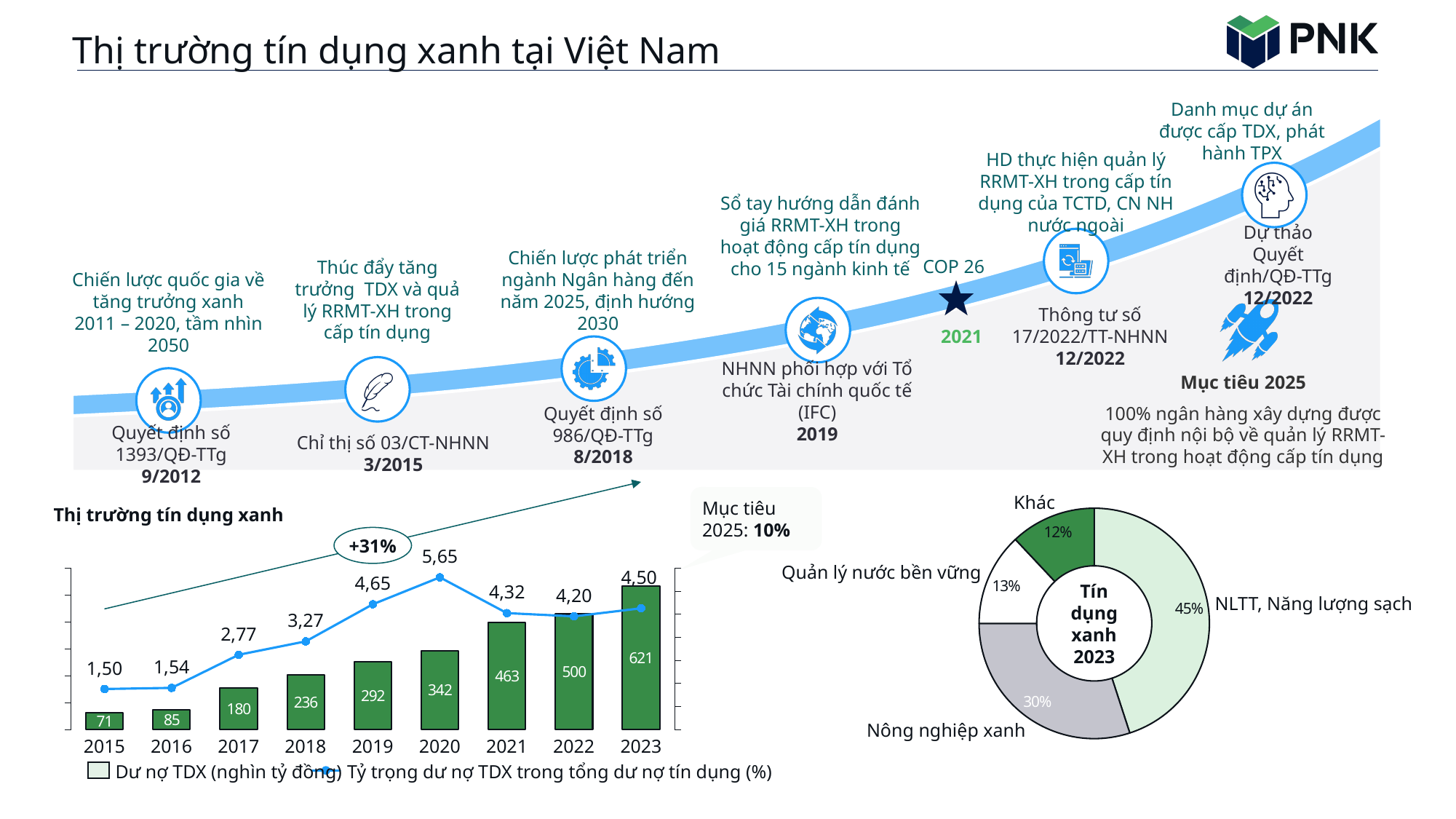
In the chart titled "Thị trường tín dụng xanh", which year has a larger Dư nợ TDX (nghìn tỷ đồng): 2019 or 2021? 2021 In the chart titled "Thị trường tín dụng xanh", which year has the highest Tỷ trọng dư nợ TDX trong tổng dư nợ tín dụng (%)? 2020 In the chart titled "Thị trường tín dụng xanh", do the Dư nợ TDX (nghìn tỷ đồng) bars rise or fall from 2015 to 2023? rise In the chart titled "Thị trường tín dụng xanh", how many years are shown on the x axis? 9 In the chart titled "Thị trường tín dụng xanh", what is the value of Dư nợ TDX (nghìn tỷ đồng) for 2023? 621 In the donut chart titled "Tín dụng xanh 2023", how many categories are shown? 4 In the chart titled "Thị trường tín dụng xanh", what is the Tỷ trọng dư nợ TDX trong tổng dư nợ tín dụng (%) for 2020? 5,65 In the donut chart titled "Tín dụng xanh 2023", which category has the smallest share? Khác In the chart titled "Thị trường tín dụng xanh", what is the difference in Dư nợ TDX (nghìn tỷ đồng) between 2023 and 2022? 121 In the chart titled "Thị trường tín dụng xanh", how many series does the legend list? 2 In the donut chart titled "Tín dụng xanh 2023", what share does NLTT, Năng lượng sạch have? 45% In the chart titled "Thị trường tín dụng xanh", which year has the lowest Dư nợ TDX (nghìn tỷ đồng)? 2015